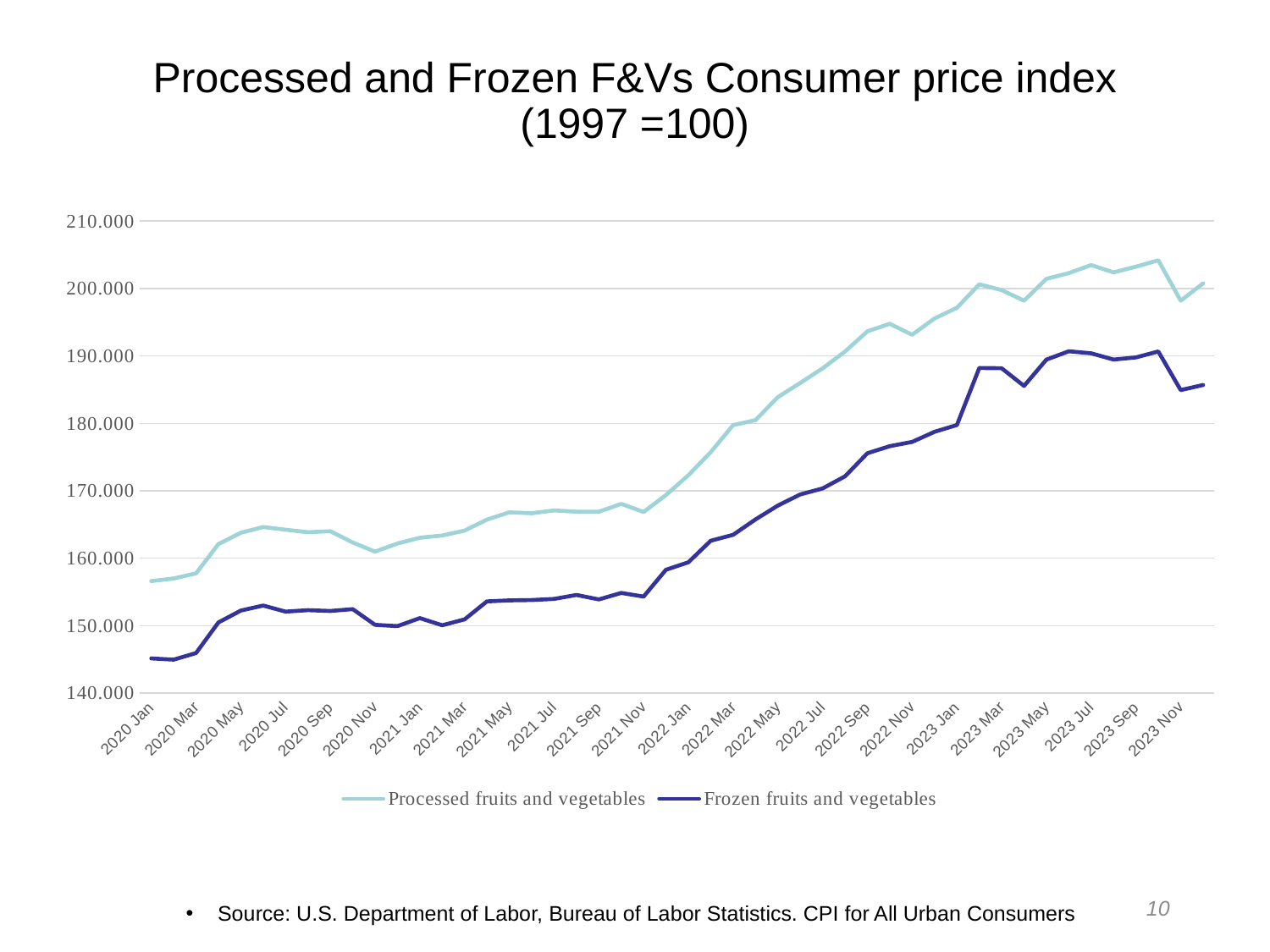
How many series does the legend list? 2 Which series has the higher value in 2023 Jul, Processed fruits and vegetables or Frozen fruits and vegetables? Processed fruits and vegetables Is the value for Processed fruits and vegetables in 2023 Jul greater or less than 200.000? greater Overall, do the values for Frozen fruits and vegetables rise or fall from 2020 Jan to 2023 Nov? rise Is the value for Frozen fruits and vegetables in 2020 Jan greater or less than 150.000? less Which series is shown in dark blue in the legend? Frozen fruits and vegetables Is the value for Frozen fruits and vegetables in 2023 Nov greater or less than 190.000? less Overall, do the values for Processed fruits and vegetables rise or fall from 2020 Jan to 2023 Nov? rise Which series has the lower value in 2020 Jan, Processed fruits and vegetables or Frozen fruits and vegetables? Frozen fruits and vegetables What kind of chart is shown on the slide? line chart What is the title of the chart? Processed and Frozen F&Vs Consumer price index (1997 =100)